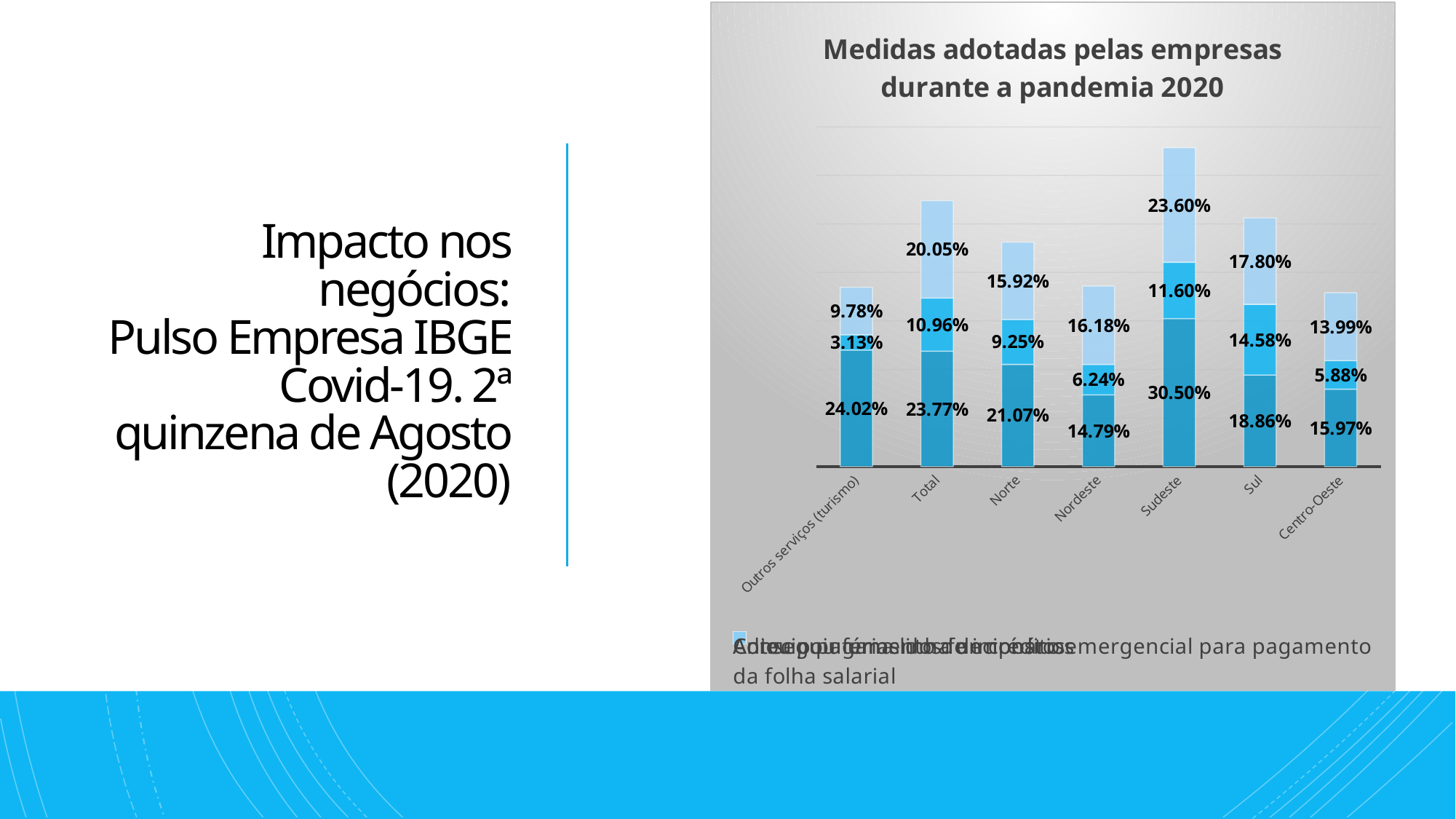
Which category has the lowest value in the bottom (darkest) segment? Nordeste What is the value of the middle segment of the Outros serviços (turismo) bar? 3.13% What is the value of the bottom (darkest) segment of the Centro-Oeste bar? 15.97% What is the difference between the bottom segment values of Sudeste and Nordeste? 15.71% What is the title of the chart? Medidas adotadas pelas empresas durante a pandemia 2020 What is the value of the top (lightest) segment of the Total bar? 20.05% Which category has the tallest stacked bar overall? Sudeste What is the total of the stacked bar for Sudeste? 65.70% What is the value of the bottom (darkest) segment of the Sudeste bar? 30.50% Which is larger: the middle segment of Sul or the middle segment of Norte? Sul Which category has the highest value in the bottom (darkest) segment? Sudeste How many categories are shown on the x axis? 7